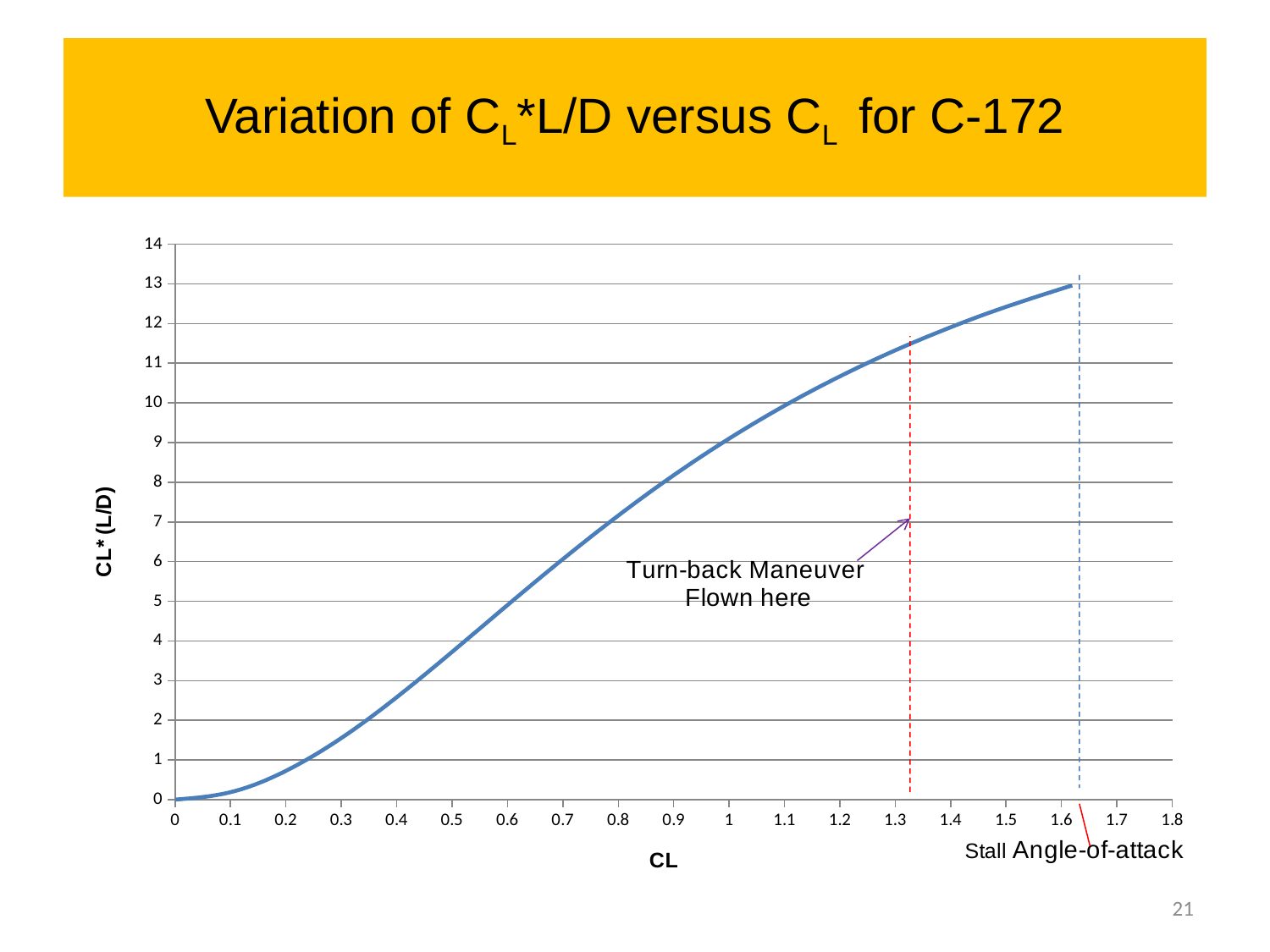
Is the value of CL*(L/D) at CL = 1 greater or less than 8? greater Is the highest value reached by the curve greater or less than 12? greater Is the value of CL*(L/D) at CL = 0.2 greater or less than 1? less Does the CL*(L/D) curve rise or fall as CL increases from 0 to 1.6? Rises What kind of chart is shown on the slide? Line chart What is the label of the x axis? CL How many curves are plotted on the chart? 1 What does the annotation with the arrow pointing to the red dashed line say? Turn-back Maneuver Flown here